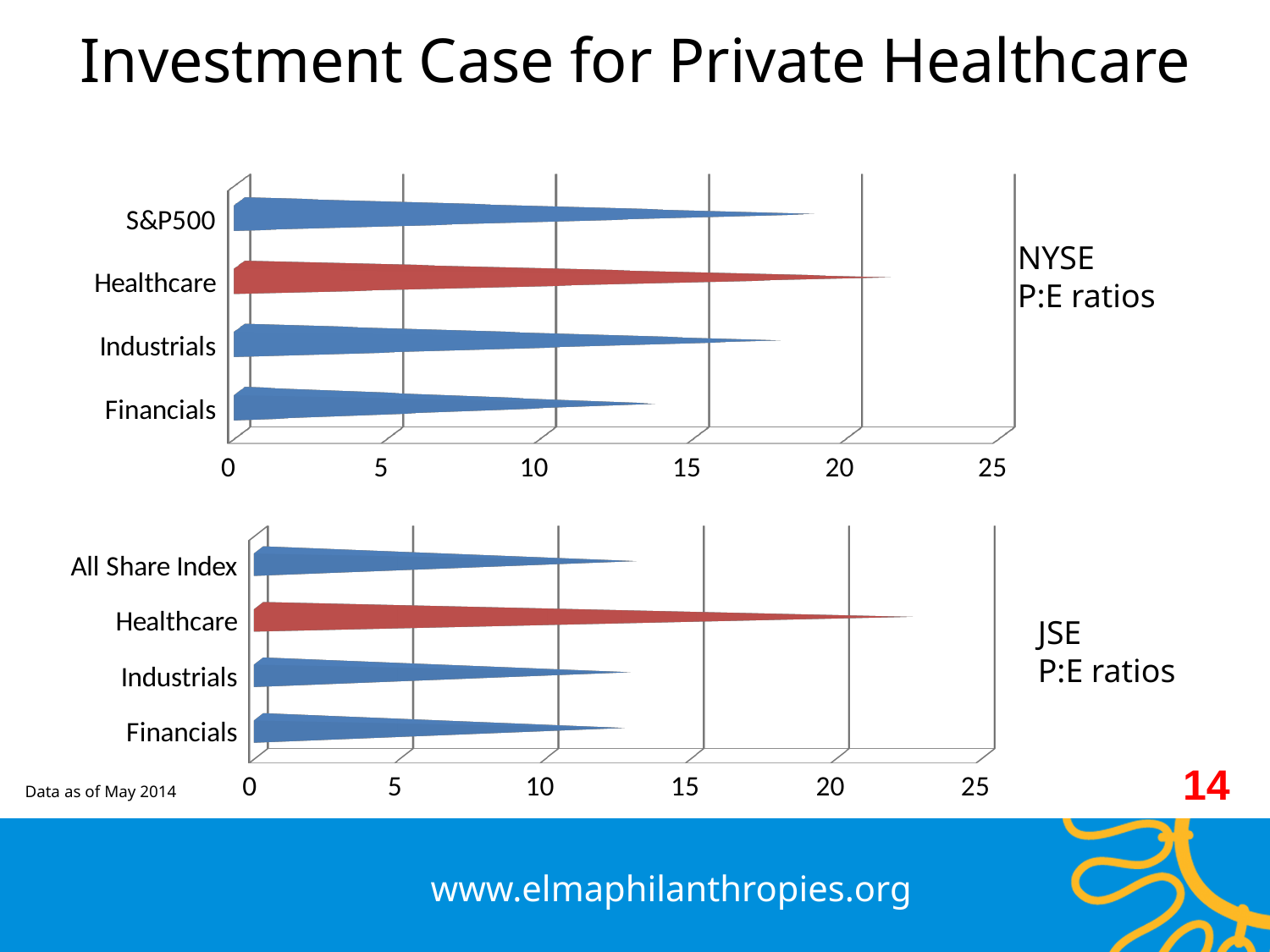
In the JSE P:E ratios chart, is the value for Industrials greater or less than 15? less How many categories are shown in the JSE P:E ratios chart? 4 In the NYSE P:E ratios chart, which category has the lowest value? Financials In the NYSE P:E ratios chart, which is larger, the value for S&P500 or the value for Financials? S&P500 In the JSE P:E ratios chart, is the value for Healthcare greater or less than 20? greater In the NYSE P:E ratios chart, is the value for Healthcare greater or less than 20? greater In the JSE P:E ratios chart, which category is shown in red? Healthcare How many categories are shown in the NYSE P:E ratios chart? 4 In the JSE P:E ratios chart, which category has the highest value? Healthcare In the NYSE P:E ratios chart, which category has the highest value? Healthcare What kind of chart is the NYSE P:E ratios chart? bar chart